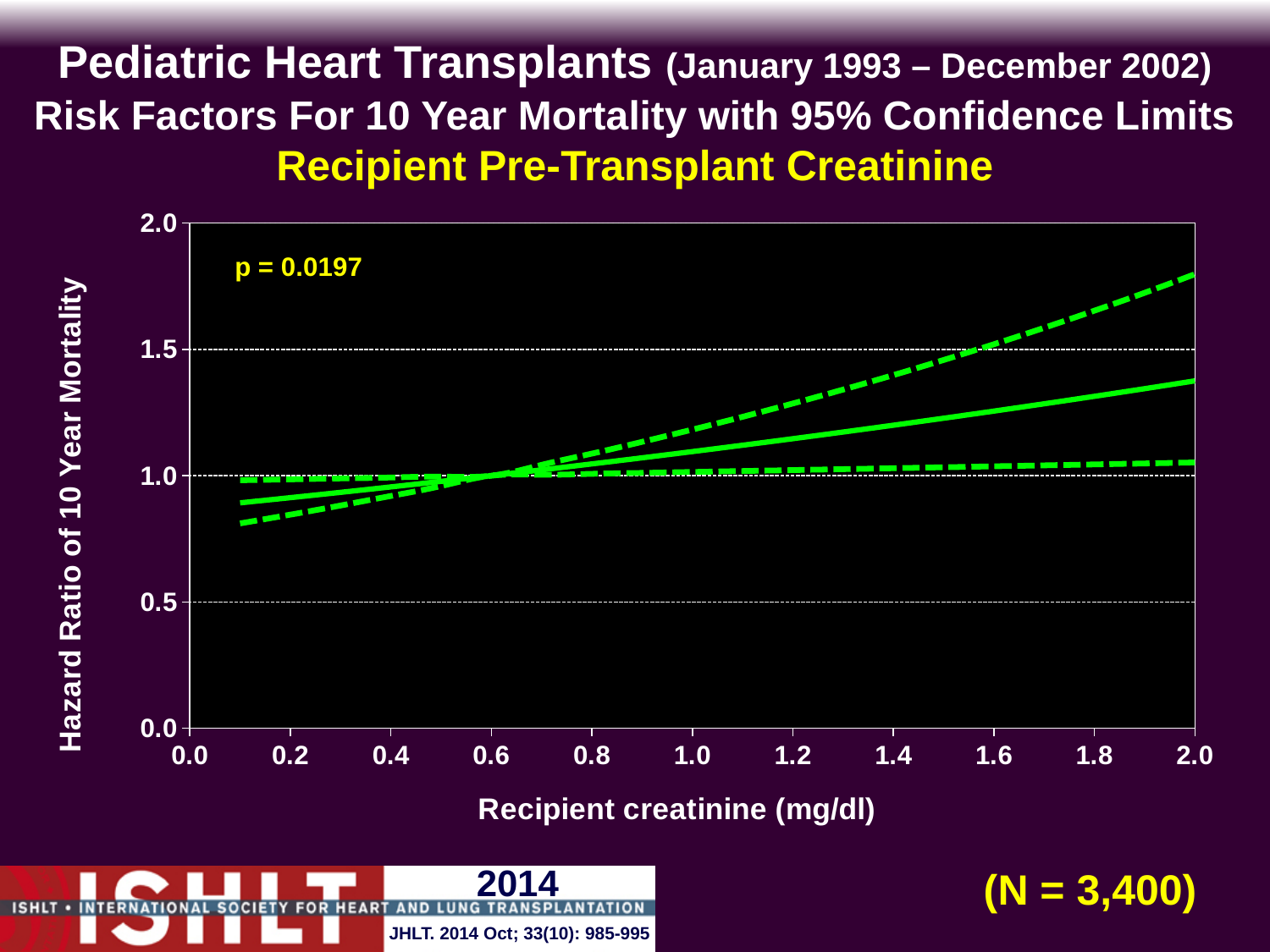
What p-value is printed on the chart? p = 0.0197 How many lines are plotted on the chart? 3 Is the hazard ratio on the solid line at a recipient creatinine of 0.2 mg/dl greater or less than 1.0? less Is the upper dashed confidence limit at a recipient creatinine of 2.0 mg/dl greater or less than 1.5? greater Does the solid hazard ratio line rise or fall as recipient creatinine increases from 0.0 to 2.0 mg/dl? rise What kind of chart is shown on the slide? line chart What is the label of the x axis? Recipient creatinine (mg/dl) What is the sample size (N) shown on the slide? N = 3,400 What is the highest value shown on the y axis? 2.0 Is the hazard ratio on the solid line at a recipient creatinine of 2.0 mg/dl greater or less than 1.0? greater